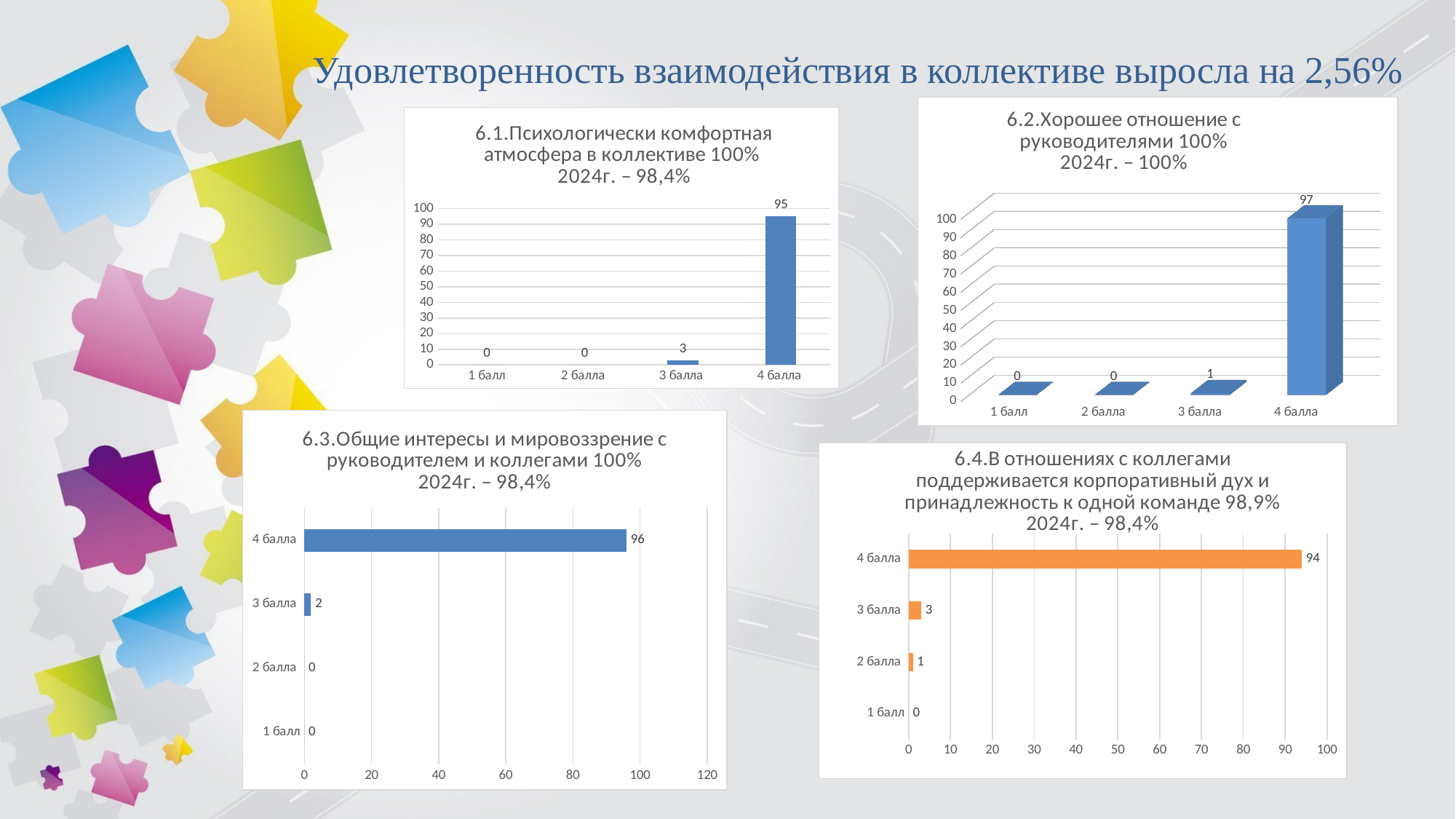
In the chart titled "6.1.Психологически комфортная атмосфера в коллективе", what is the value for 3 балла? 3 In the chart titled "6.3.Общие интересы и мировоззрение с руководителем и коллегами", what is the value for 3 балла? 2 In the chart titled "6.4.В отношениях с коллегами поддерживается корпоративный дух и принадлежность к одной команде", what is the value for 4 балла? 94 In the chart titled "6.1.Психологически комфортная атмосфера в коллективе", what is the value for 4 балла? 95 In the chart titled "6.2.Хорошее отношение с руководителями", which category has the highest value? 4 балла What type of chart is the chart titled "6.4.В отношениях с коллегами поддерживается корпоративный дух и принадлежность к одной команде"? Bar chart Which is larger: the value for 4 балла in chart 6.1 or the value for 4 балла in chart 6.2? Chart 6.2 (97) In the chart titled "6.2.Хорошее отношение с руководителями", what is the value for 4 балла? 97 In the chart titled "6.4.В отношениях с коллегами поддерживается корпоративный дух и принадлежность к одной команде", what is the value for 2 балла? 1 What colour are the bars in the chart titled "6.4.В отношениях с коллегами поддерживается корпоративный дух и принадлежность к одной команде"? Orange In the chart titled "6.3.Общие интересы и мировоззрение с руководителем и коллегами", what is the difference between the values for 4 балла and 3 балла? 94 How many categories are shown in the chart titled "6.3.Общие интересы и мировоззрение с руководителем и коллегами"? 4